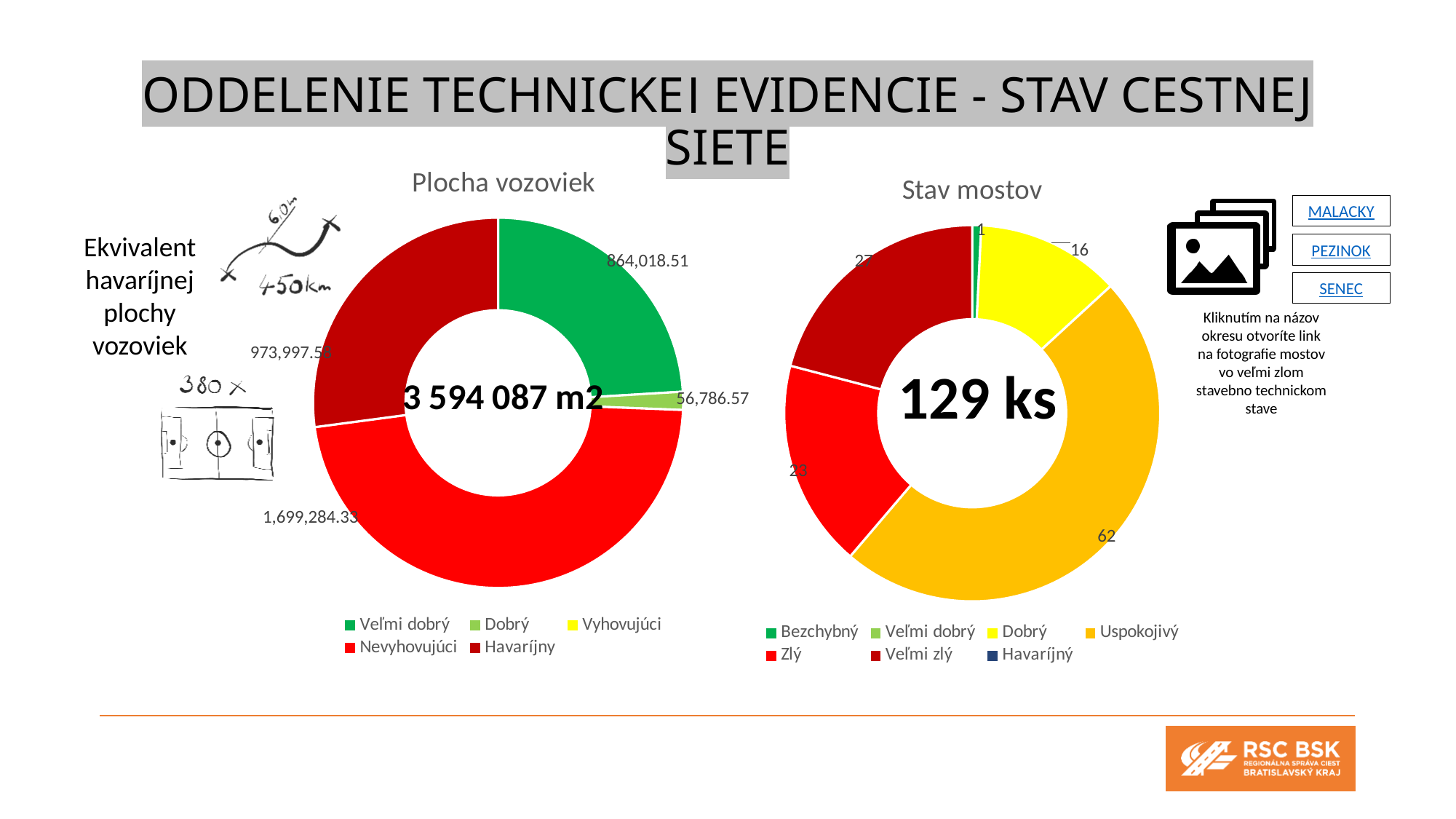
In the "Plocha vozoviek" chart, what is the value for Veľmi dobrý? 864,018.51 In the "Plocha vozoviek" chart, which is larger: Veľmi dobrý or Havarijny? Havarijny In the "Stav mostov" chart, what is the difference between Veľmi zlý and Zlý? 4 What total is shown in the centre of the "Stav mostov" chart? 129 ks In the "Stav mostov" chart, which category has the largest slice? Uspokojivý In the "Plocha vozoviek" chart, which category has the largest slice? Nevyhovujúci In the "Stav mostov" chart, what is the value for Uspokojivý? 62 How many entries does the legend of the "Plocha vozoviek" chart list? 5 In the "Plocha vozoviek" chart, what is the value for Nevyhovujúci? 1,699,284.33 In the "Plocha vozoviek" chart, what is the value for Dobrý? 56,786.57 In the "Stav mostov" chart, what is the value for Zlý? 23 What kind of chart is the "Plocha vozoviek" chart? Pie chart (doughnut)